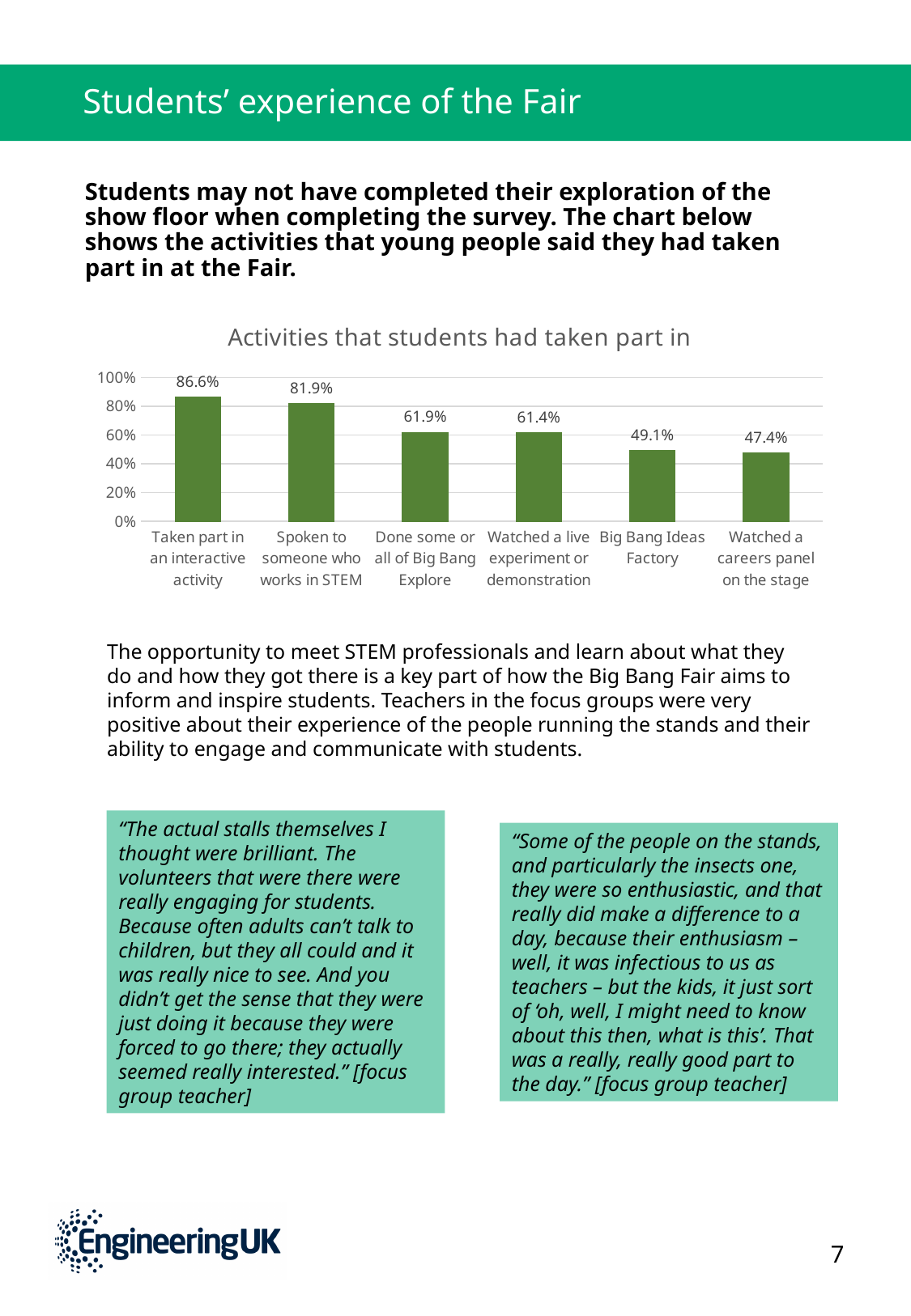
What kind of chart is shown on the slide? Bar chart What percentage of students had spoken to someone who works in STEM? 81.9% Which activity has the highest percentage of students taking part? Taken part in an interactive activity What is the difference between 'Big Bang Ideas Factory' and 'Watched a careers panel on the stage'? 1.7% What is the title of the chart? Activities that students had taken part in How many activities are shown in the chart? 6 Which activity has the lowest percentage of students taking part? Watched a careers panel on the stage What is the value for 'Watched a careers panel on the stage'? 47.4% What percentage of students said they had taken part in an interactive activity? 86.6% What is the difference between 'Taken part in an interactive activity' and 'Spoken to someone who works in STEM'? 4.7% Is the value for 'Watched a live experiment or demonstration' greater or less than 80%? less Which is larger: 'Done some or all of Big Bang Explore' or 'Big Bang Ideas Factory'? Done some or all of Big Bang Explore